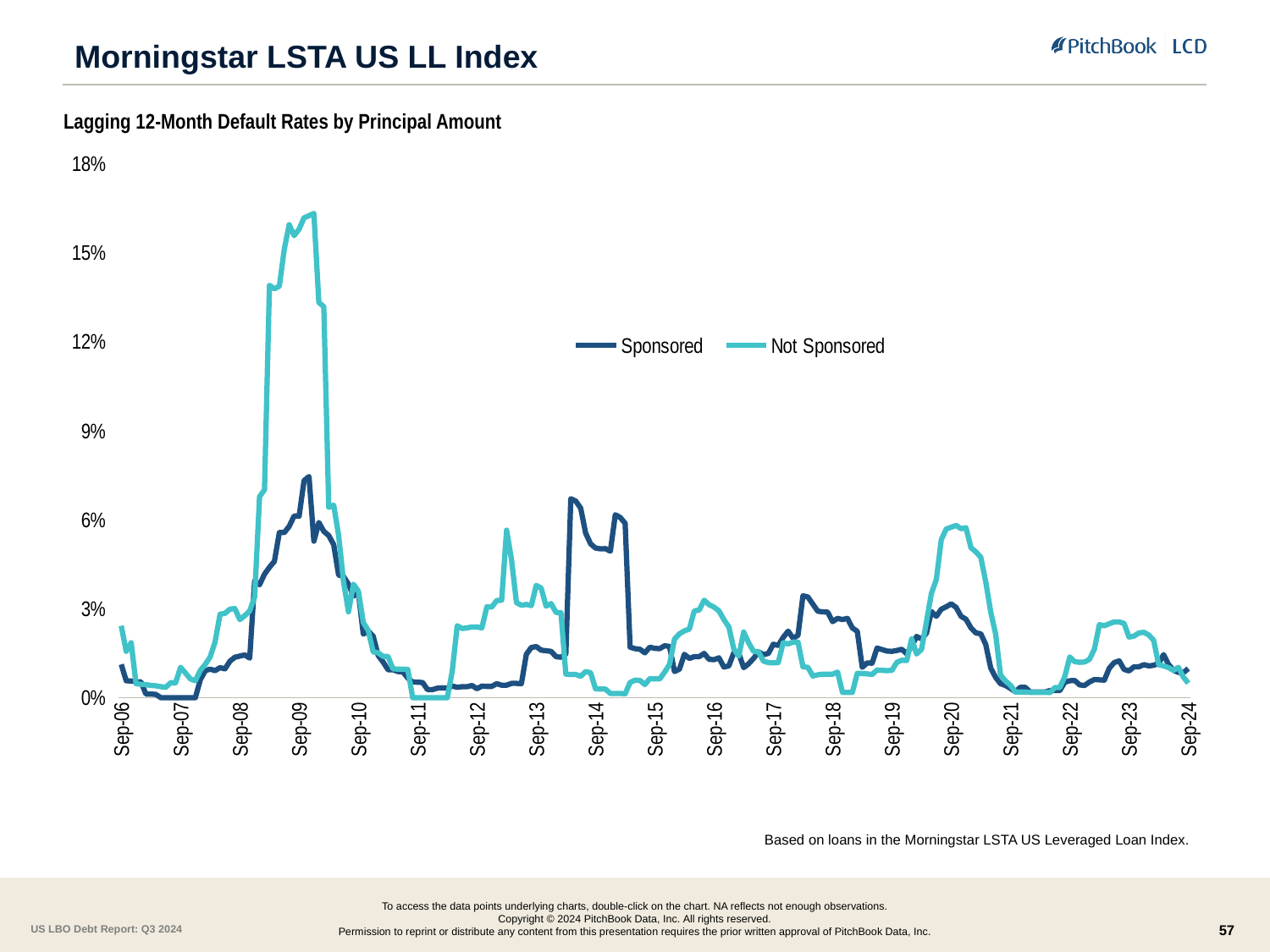
Which series reaches the highest default rate anywhere on the chart? Not Sponsored What is the title of the chart? Lagging 12-Month Default Rates by Principal Amount Is the peak value of the Sponsored series around Sep-09 greater or less than 6%? greater Around Sep-14, which series has the higher default rate, Sponsored or Not Sponsored? Sponsored Does the Not Sponsored series rise or fall between Sep-09 and Sep-11? Fall Is the Not Sponsored value around Sep-14 greater or less than 3%? less How many year labels are shown on the x axis? 19 Is the peak value of the Not Sponsored series around Sep-09 greater or less than 15%? greater Around Sep-20, which series has the higher default rate, Sponsored or Not Sponsored? Not Sponsored Which series is drawn in the lighter teal colour? Not Sponsored How many series does the legend list? 2 What kind of chart is shown on the slide? Line chart